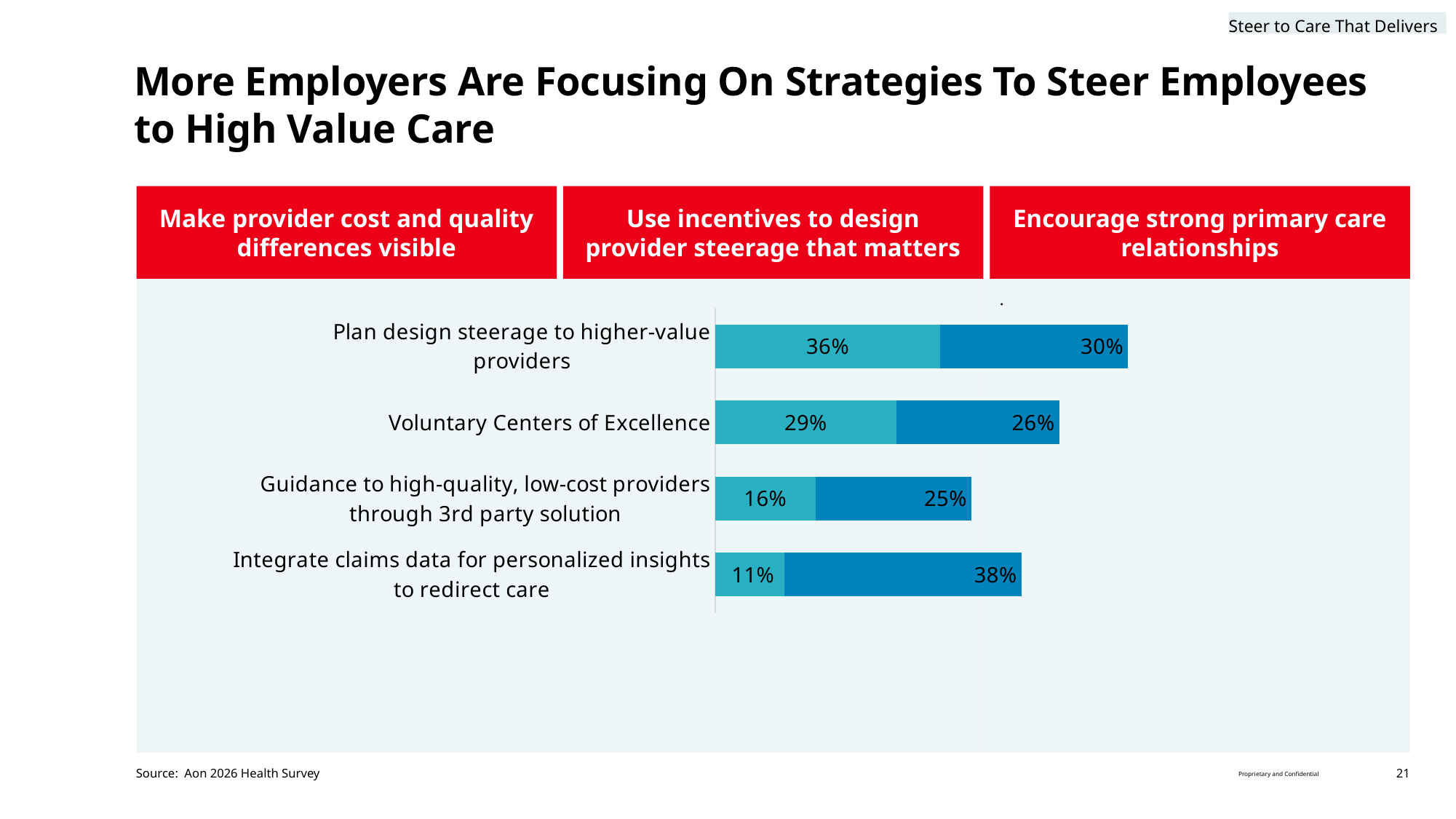
What is the value of the teal (left) segment for "Plan design steerage to higher-value providers"? 36% How many categories does the bar chart show? 4 What is the total of the stacked bar for "Plan design steerage to higher-value providers"? 66% Which is larger: the teal segment for "Voluntary Centers of Excellence" or the teal segment for "Guidance to high-quality, low-cost providers through 3rd party solution"? Voluntary Centers of Excellence What is the total of the stacked bar for "Voluntary Centers of Excellence"? 55% Which category has the lowest teal (left) segment value? Integrate claims data for personalized insights to redirect care What kind of chart is shown on the slide? Stacked bar chart What is the value of the teal (left) segment for "Voluntary Centers of Excellence"? 29% What is the value of the dark blue (right) segment for "Guidance to high-quality, low-cost providers through 3rd party solution"? 25% What is the difference between the dark blue segment and the teal segment for "Integrate claims data for personalized insights to redirect care"? 27% Which category has the highest teal (left) segment value? Plan design steerage to higher-value providers What is the value of the dark blue (right) segment for "Integrate claims data for personalized insights to redirect care"? 38%